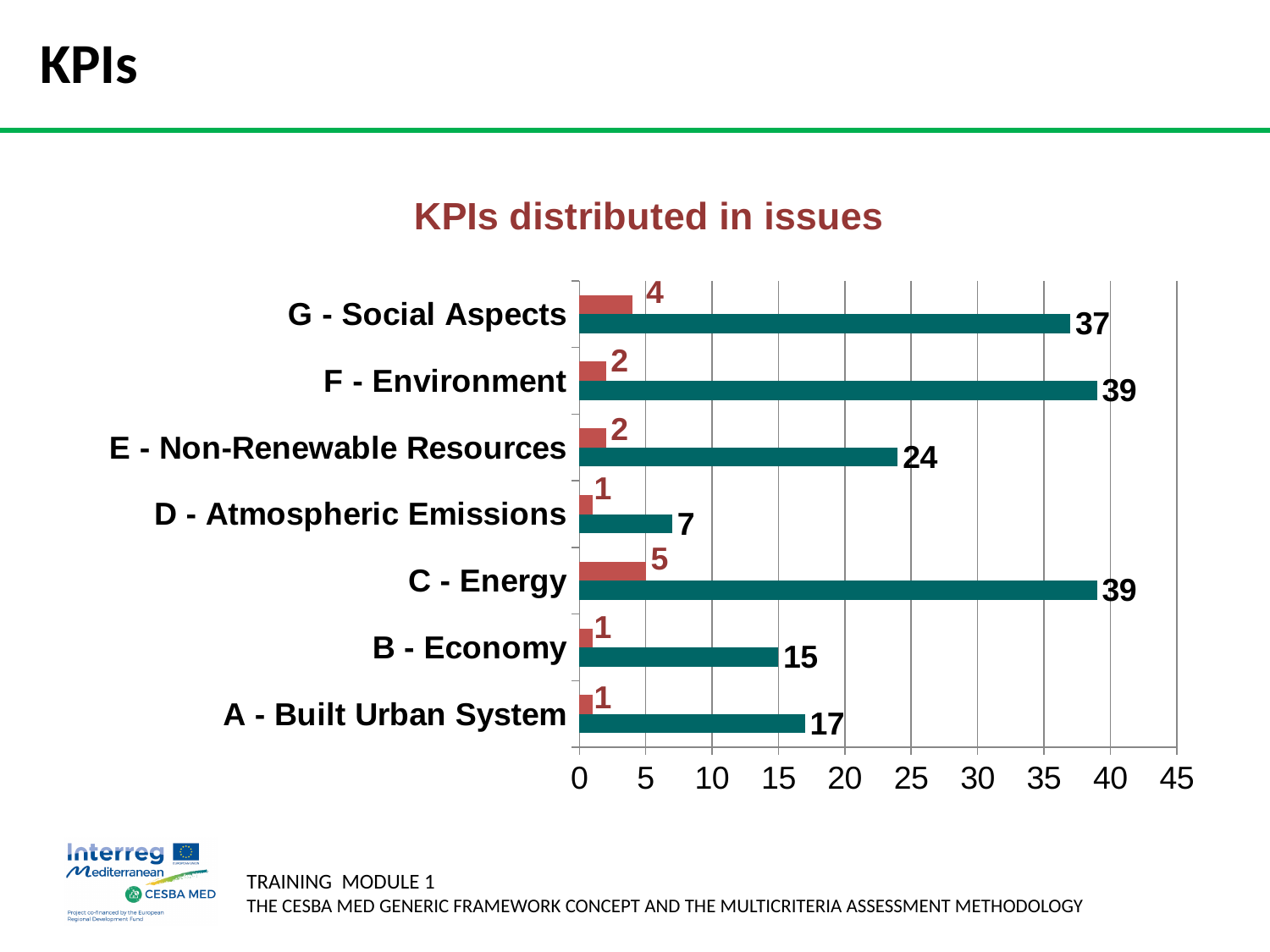
What is the value of the teal bar for E - Non-Renewable Resources? 24 Which category has the highest red bar value? C - Energy What is the value of the teal bar for A - Built Urban System? 17 What type of chart is shown on the slide? bar chart Which category has the lowest teal bar value? D - Atmospheric Emissions Is the teal bar value for E - Non-Renewable Resources greater or less than 20? greater What is the title of the chart? KPIs distributed in issues Which has a larger teal bar value, B - Economy or A - Built Urban System? A - Built Urban System What is the difference between the teal bar values for C - Energy and D - Atmospheric Emissions? 32 How many categories (issues) are shown on the chart? 7 What is the value of the red bar for C - Energy? 5 What is the difference between the teal bar values for F - Environment and G - Social Aspects? 2